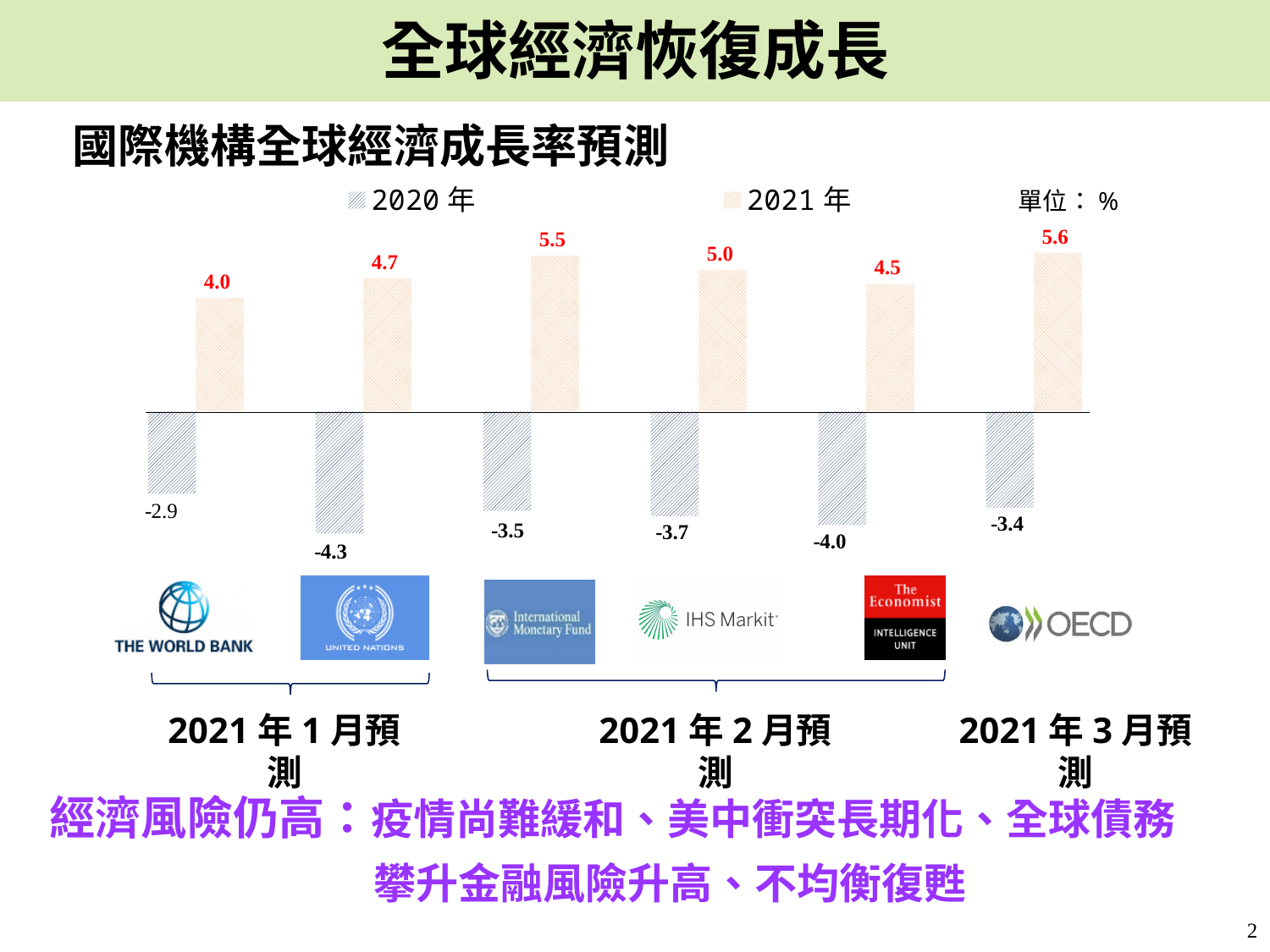
Which is larger, the 2021年 forecast of IHS Markit or of The Economist Intelligence Unit? IHS Markit What is the 2020年 value for OECD? -3.4 What is the 2021年 forecast value for THE WORLD BANK? 4.0 How many institutions are shown in the chart? 6 Which institution has the lowest 2020年 value? UNITED NATIONS What kind of chart is shown on the slide? bar chart What is the 2021年 forecast value for the International Monetary Fund? 5.5 What is the difference between the 2021年 forecasts of OECD and THE WORLD BANK? 1.6 Which institution has the highest 2021年 forecast? OECD How many series does the legend list? 2 What is the 2020年 value for UNITED NATIONS? -4.3 What unit is stated for the chart values? %